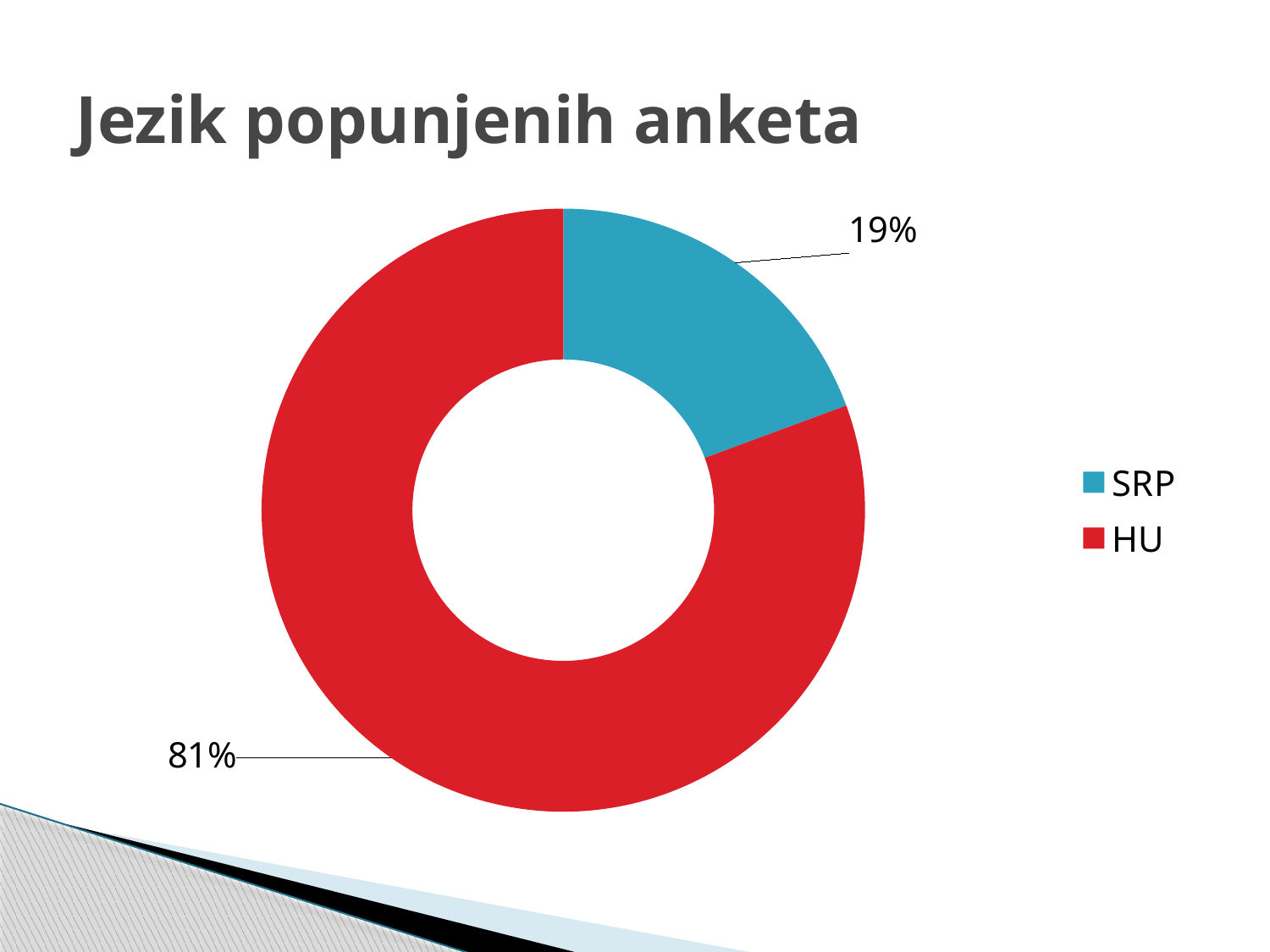
Which is larger, the share for SRP or the share for HU? HU What kind of chart is shown on the slide? Doughnut (pie) chart What share of the doughnut chart does SRP represent? 19% What is the difference in percentage points between the HU and SRP shares? 62 How many entries does the legend list? 2 How many categories are shown in the chart? 2 Which category has the smallest share in the chart? SRP What share of the doughnut chart does HU represent? 81% What colour is the HU segment of the chart? Red What is the title of the slide? Jezik popunjenih anketa Which category has the largest share in the chart? HU